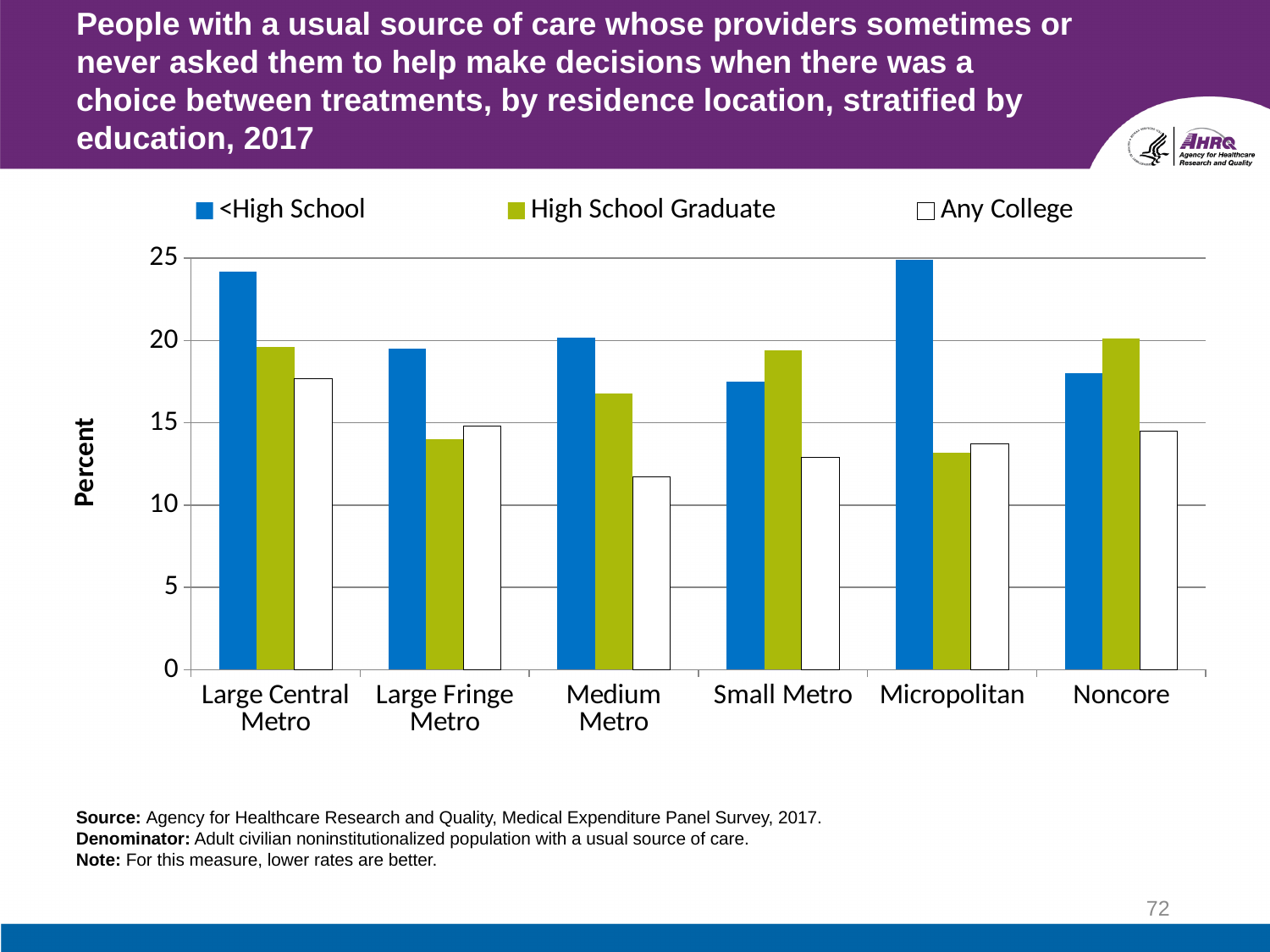
Which residence location has the lowest value for the High School Graduate series? Micropolitan What kind of chart is shown on the slide? bar chart What is the label on the vertical axis of the chart? Percent Is the <High School value for Large Central Metro greater or less than 20? greater For Noncore, which is larger: the High School Graduate value or the Any College value? High School Graduate Which residence location has the highest value for the <High School series? Micropolitan Is the High School Graduate value for Large Fringe Metro greater or less than 15? less Which residence location has the lowest value for the Any College series? Medium Metro How many series does the legend list? 3 Is the Any College value for Medium Metro greater or less than 15? less How many residence location categories are shown on the x axis? 6 For Small Metro, which is larger: the <High School value or the High School Graduate value? High School Graduate